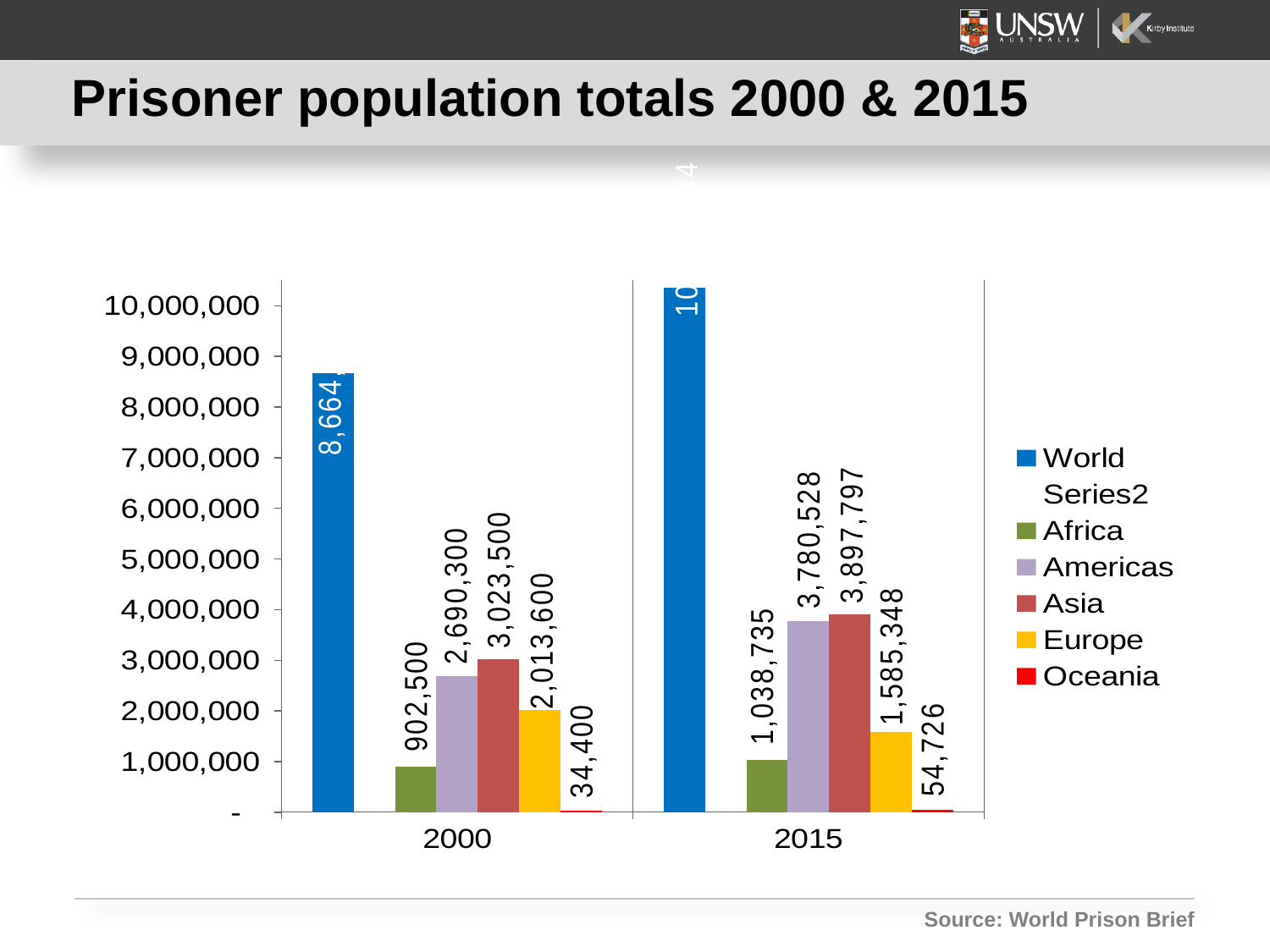
By how much did Asia's prisoner population increase from 2000 to 2015? 874,297 Which region has the lowest prisoner population in 2000? Oceania How many year groups are shown on the x axis? 2 What is the prisoner population for Oceania in 2000? 34,400 What is the prisoner population for Africa in 2000? 902,500 What is the prisoner population for Asia in 2015? 3,897,797 Excluding the World total, which region has the highest prisoner population in 2015? Asia What is the prisoner population for Europe in 2015? 1,585,348 Which is larger: Europe's prisoner population in 2000 or in 2015? 2000 Is the World prisoner population in 2015 greater or less than 10,000,000? greater What type of chart is shown on the slide? Bar chart How many series does the legend list? 7